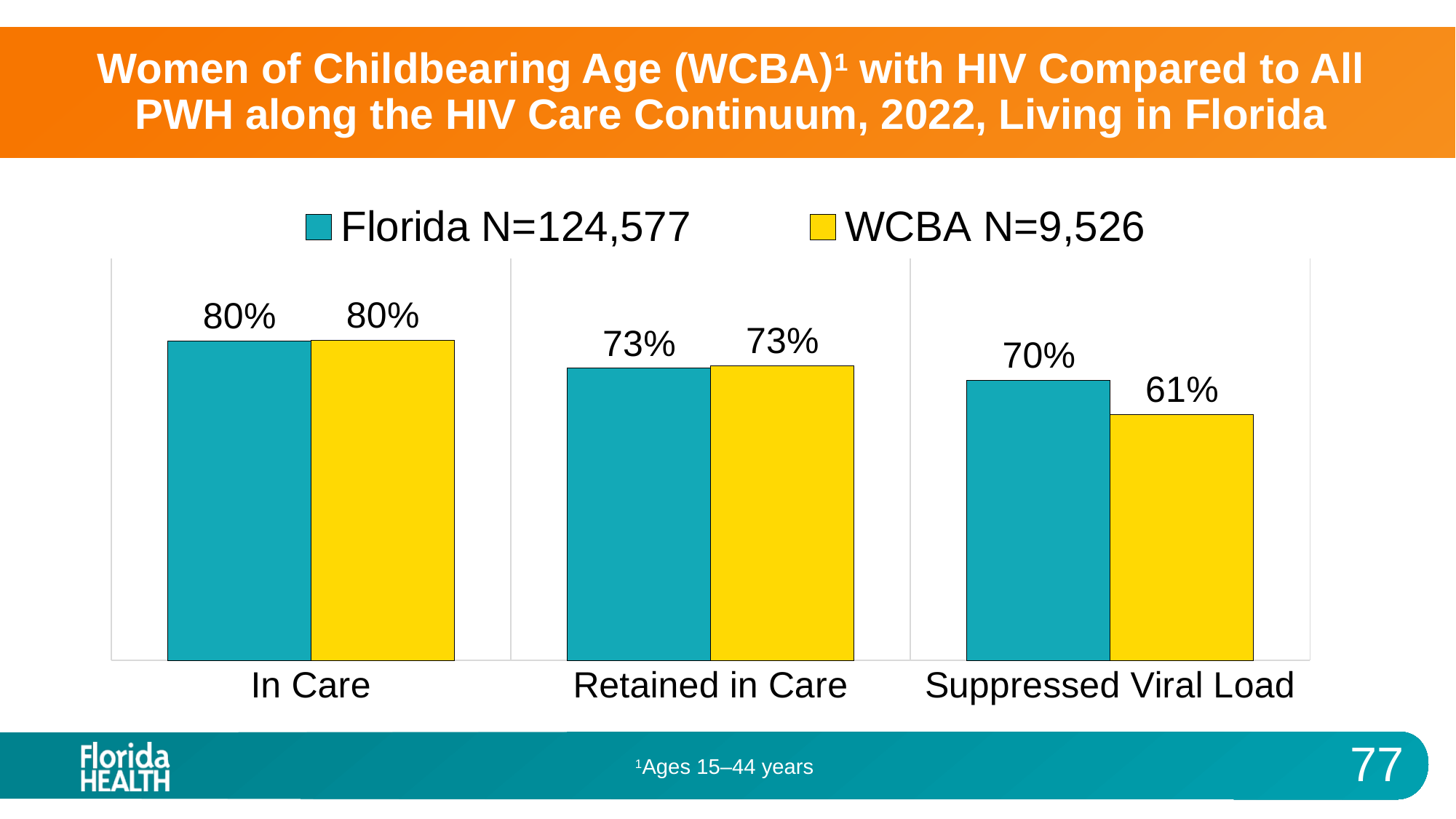
Which category has the highest value for the Florida series? In Care How many series does the legend list? 2 Which category has the lowest value for the WCBA series? Suppressed Viral Load In the Suppressed Viral Load category, which series has the larger value, Florida or WCBA? Florida What is the value for WCBA in the Retained in Care category? 73% What is the value for WCBA in the Suppressed Viral Load category? 61% Do the WCBA values rise or fall from In Care to Suppressed Viral Load? Fall How many categories are shown on the x axis? 3 What is the difference between the Florida and WCBA values in the Suppressed Viral Load category? 9% What is the value for Florida in the Retained in Care category? 73% What is the value for Florida in the In Care category? 80% What kind of chart is shown on the slide? Bar chart